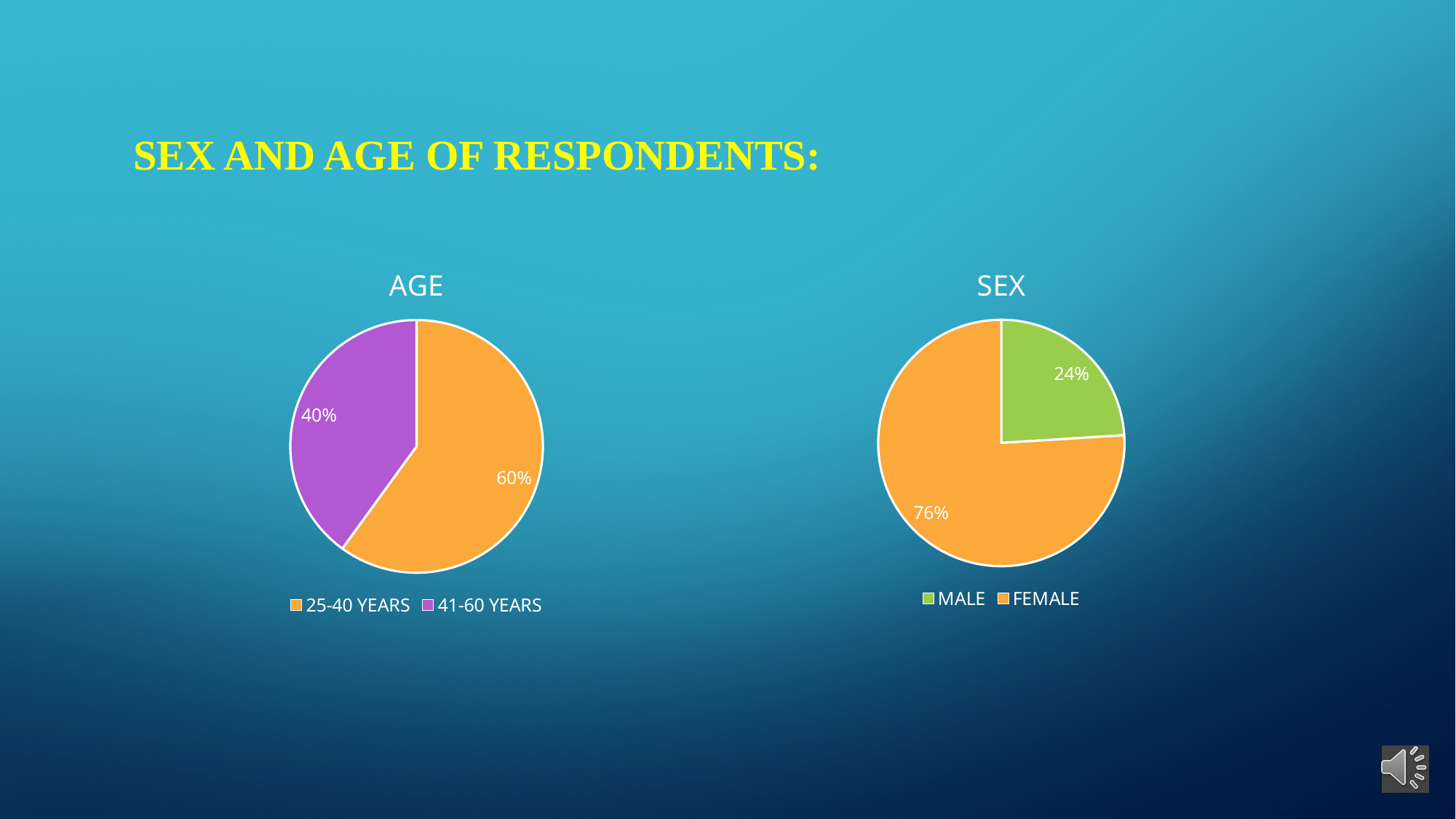
In the SEX chart, what share of respondents are male? 24% What type of chart is the SEX chart? pie chart In the SEX chart, what is the difference between the female share and the male share? 52% In the SEX chart, is the female share larger or smaller than the male share? larger In the SEX chart, which category has the smaller share? MALE In the AGE chart, which age group has the larger share? 25-40 YEARS In the SEX chart, what share of respondents are female? 76% In the AGE chart, what share of respondents are 41-60 years old? 40% In the SEX chart, what colour is the MALE slice? green In the AGE chart, what share of respondents are 25-40 years old? 60% In the AGE chart, what is the difference between the 25-40 years share and the 41-60 years share? 20% How many slices does the AGE chart have? 2